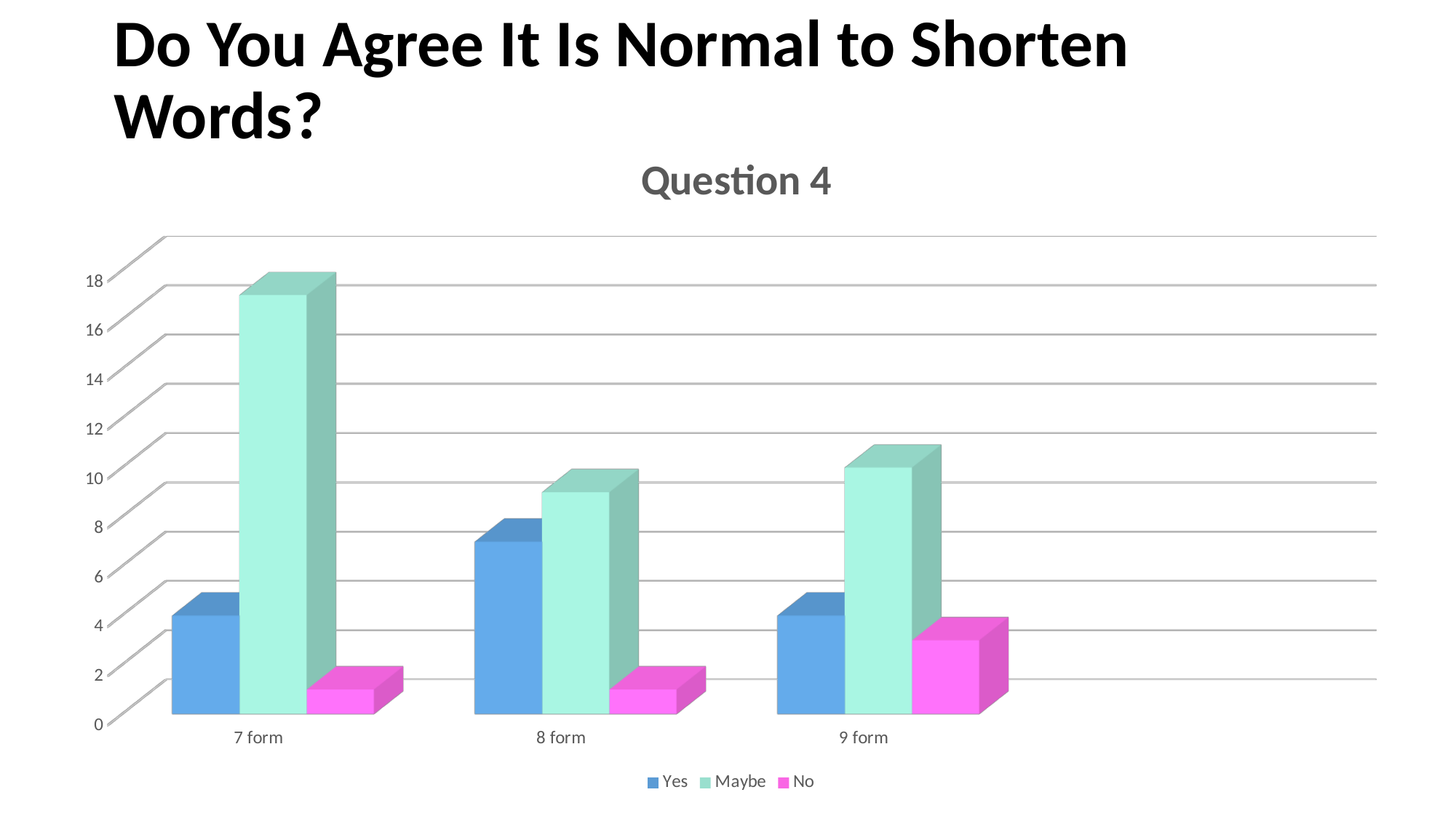
Which response has the lowest value for 7 form? No How many series does the chart's legend list? 3 For 8 form, which is larger, the Yes value or the Maybe value? Maybe Which is larger, the No value for 9 form or the No value for 8 form? 9 form What kind of chart is shown on the slide? bar chart Is the No value for 9 form greater or less than 4? less Which series is shown in pink in the chart? No How many form groups are shown on the x axis of the chart? 3 Which response has the highest value for 9 form? Maybe Which form has the highest Maybe value? 7 form What is the title of the chart? Question 4 Is the Maybe value for 7 form greater or less than 14? greater